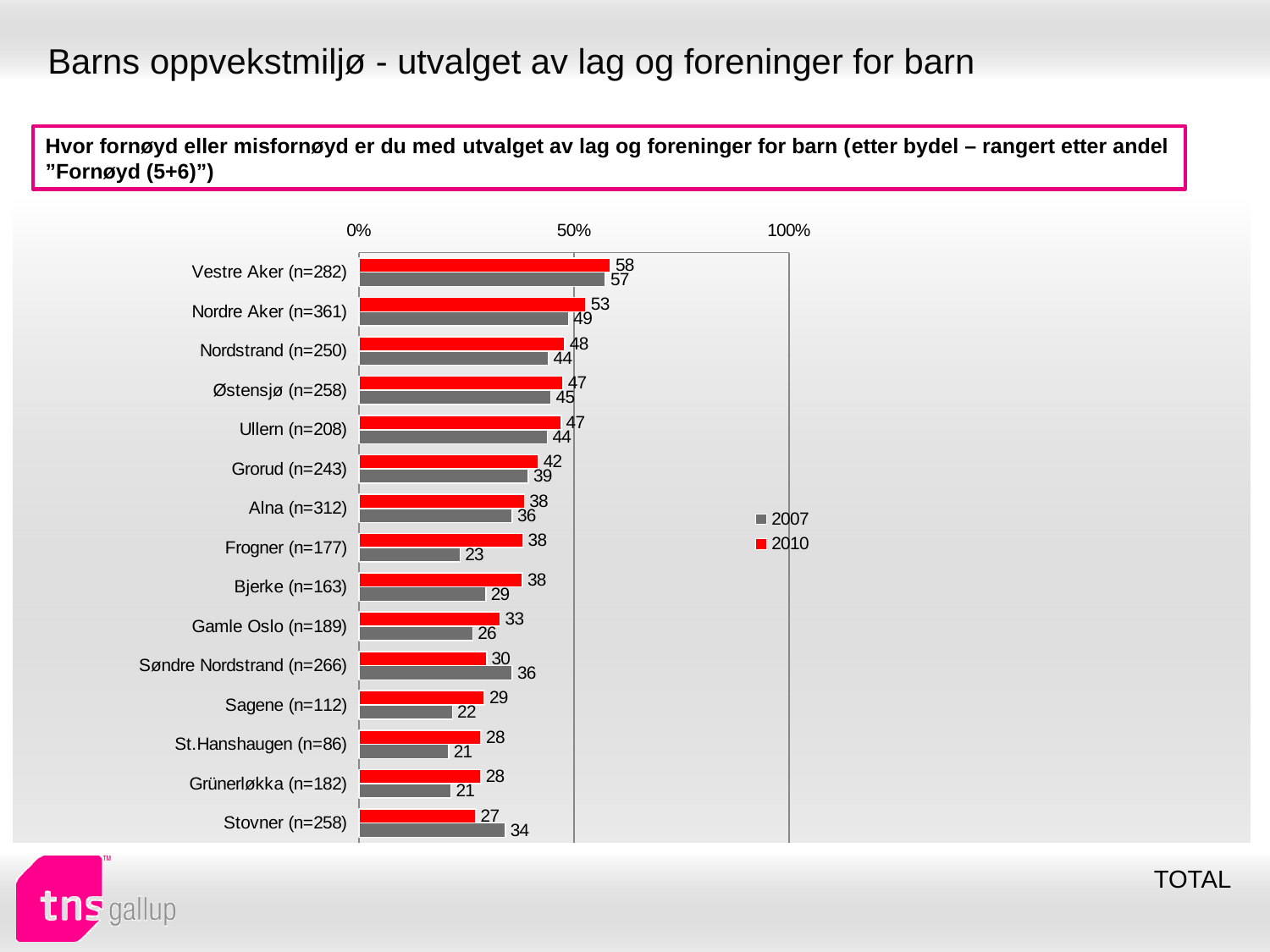
What is the 2007 value for Frogner (n=177)? 23 Which is larger for Søndre Nordstrand (n=266): the 2007 value or the 2010 value? 2007 How many series does the legend list? 2 Which colour represents the 2010 series in the legend? red Which district has the lowest 2010 value? Stovner (n=258) What is the difference between the 2010 and 2007 values for Frogner (n=177)? 15 Which district has the highest 2010 value? Vestre Aker (n=282) What is the 2010 value for Vestre Aker (n=282)? 58 Is the 2010 value for Nordre Aker (n=361) greater or less than 50%? greater What is the 2007 value for Stovner (n=258)? 34 How many districts are shown on the chart? 15 What kind of chart is shown on the slide? bar chart